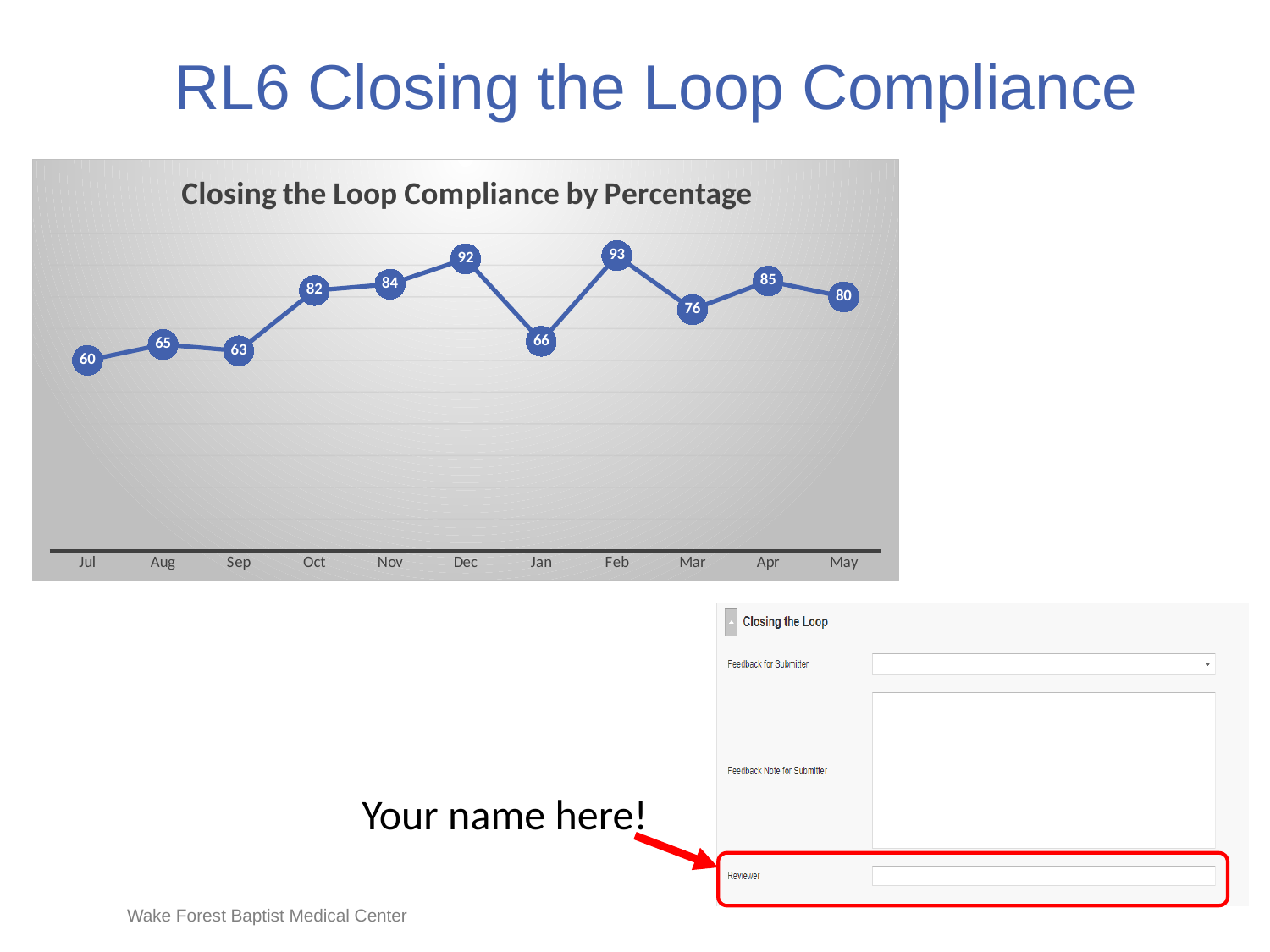
What is the difference between the values for Feb and Jan? 27 What is the compliance value for Dec? 92 What kind of chart is shown? Line chart Do the values rise or fall from Jul to Oct? Rise What is the difference between the values for Apr and May? 5 Which month has the highest compliance value? Feb What is the compliance value for Jul? 60 What is the compliance value for Mar? 76 What is the title of the chart? Closing the Loop Compliance by Percentage Which month has the lowest compliance value? Jul How many months are plotted on the x axis? 11 Which is larger, the value for Oct or the value for Nov? Nov